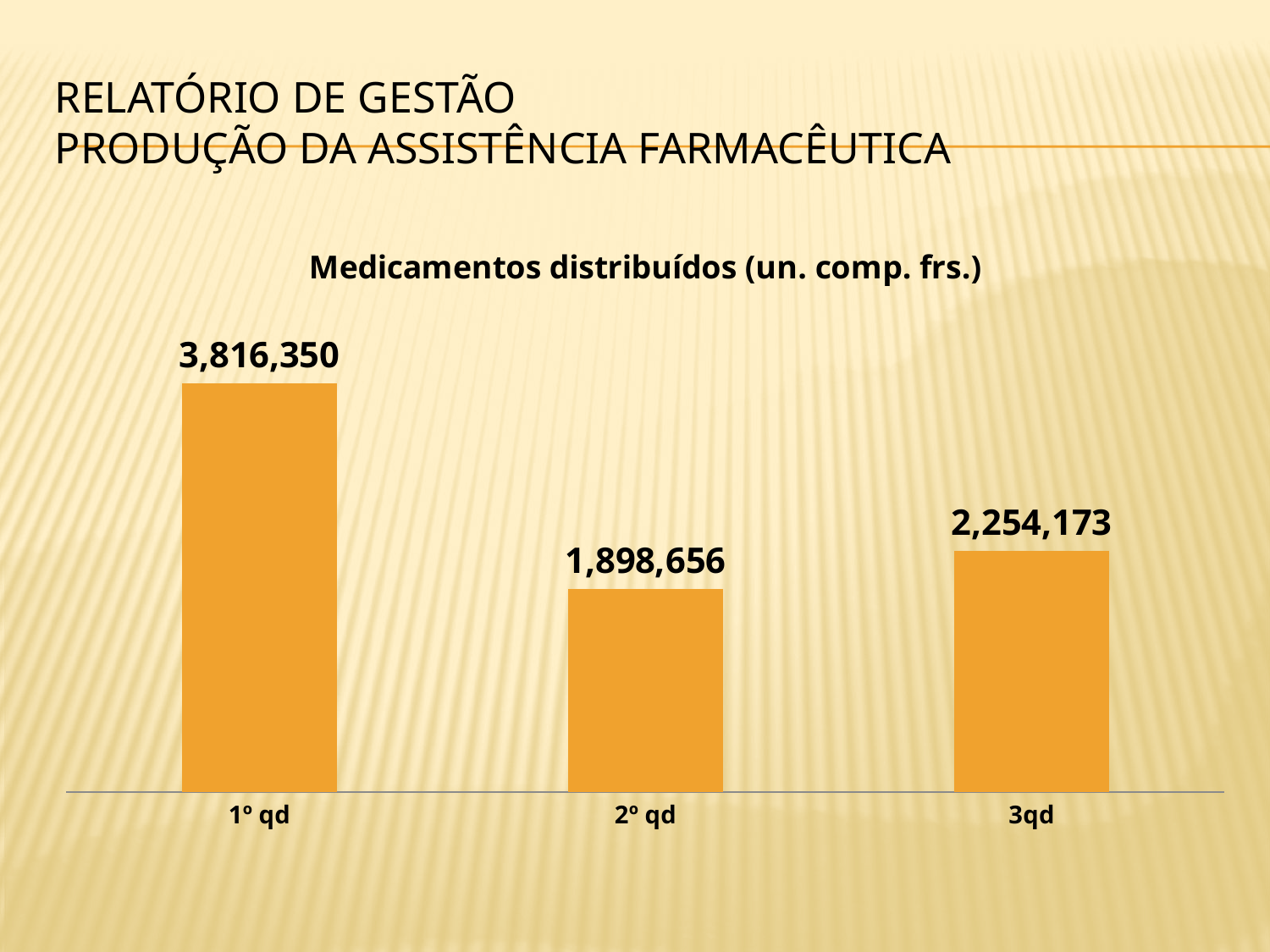
What is the title of the chart on the slide? Medicamentos distribuídos (un. comp. frs.) What is the difference between the values for 3qd and 2º qd? 355,517 What is the value for 3qd in the Medicamentos distribuídos chart? 2,254,173 What is the value for 1º qd in the Medicamentos distribuídos chart? 3,816,350 Which is larger, the value for 2º qd or the value for 3qd? 3qd Which category has the highest value in the Medicamentos distribuídos chart? 1º qd What is the value for 2º qd in the Medicamentos distribuídos chart? 1,898,656 What is the difference between the values for 1º qd and 2º qd? 1,917,694 What kind of chart is shown on the slide? Bar chart How many categories are shown in the Medicamentos distribuídos chart? 3 Which category has the lowest value in the Medicamentos distribuídos chart? 2º qd Does the value rise or fall from 1º qd to 2º qd? Fall